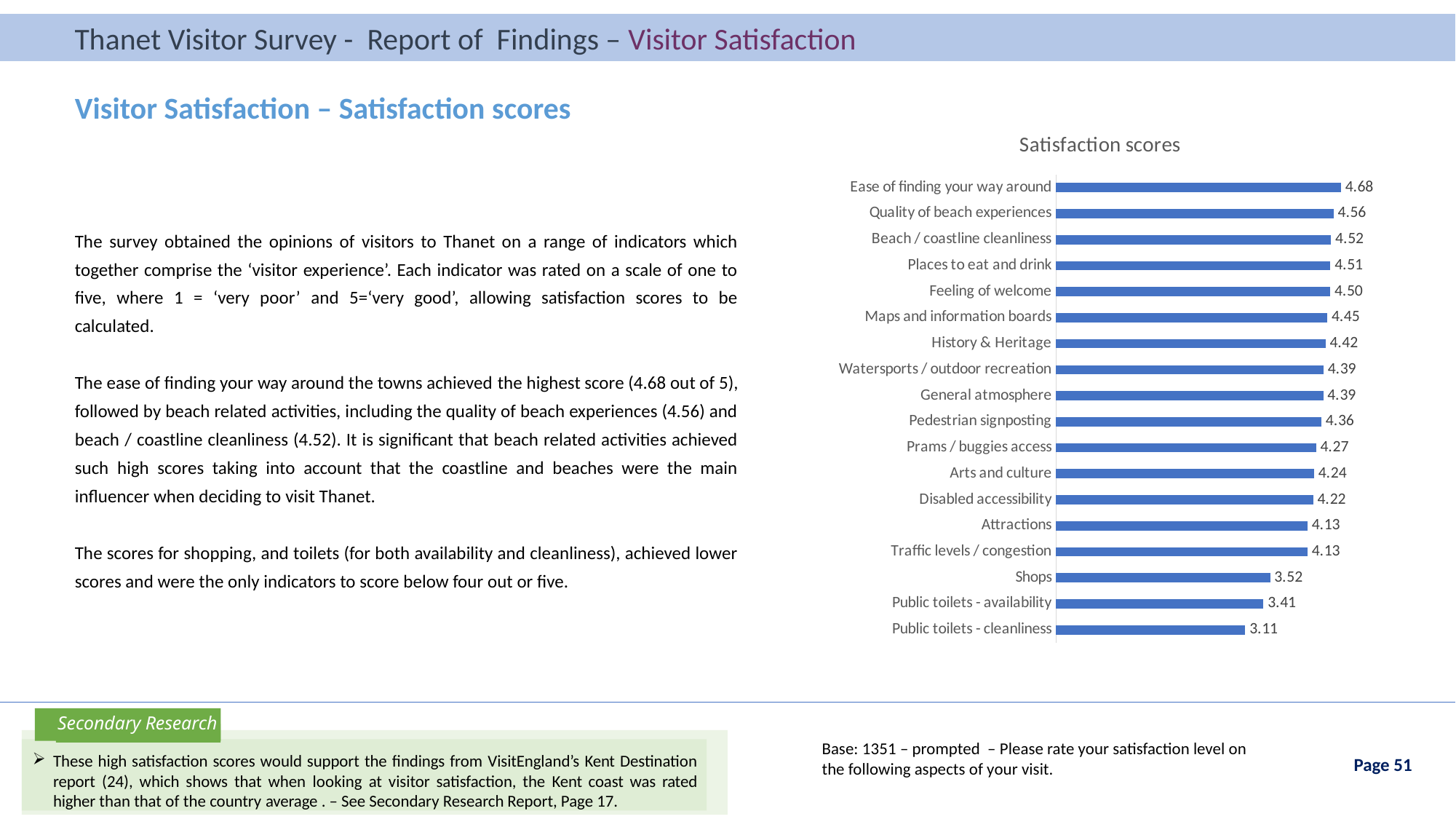
What kind of chart is used to show the satisfaction scores? Bar chart What is the satisfaction score for History & Heritage? 4.42 Which category has the lowest satisfaction score? Public toilets - cleanliness What is the difference between the satisfaction scores for Quality of beach experiences and Shops? 1.04 What is the satisfaction score for Shops? 3.52 Which category has the highest satisfaction score? Ease of finding your way around What is the title of the chart? Satisfaction scores What is the satisfaction score for Public toilets - cleanliness? 3.11 What is the difference between the satisfaction scores for Ease of finding your way around and Public toilets - cleanliness? 1.57 How many categories are shown in the Satisfaction scores chart? 18 What is the satisfaction score for Ease of finding your way around? 4.68 Which has a higher satisfaction score, Prams / buggies access or Attractions? Prams / buggies access